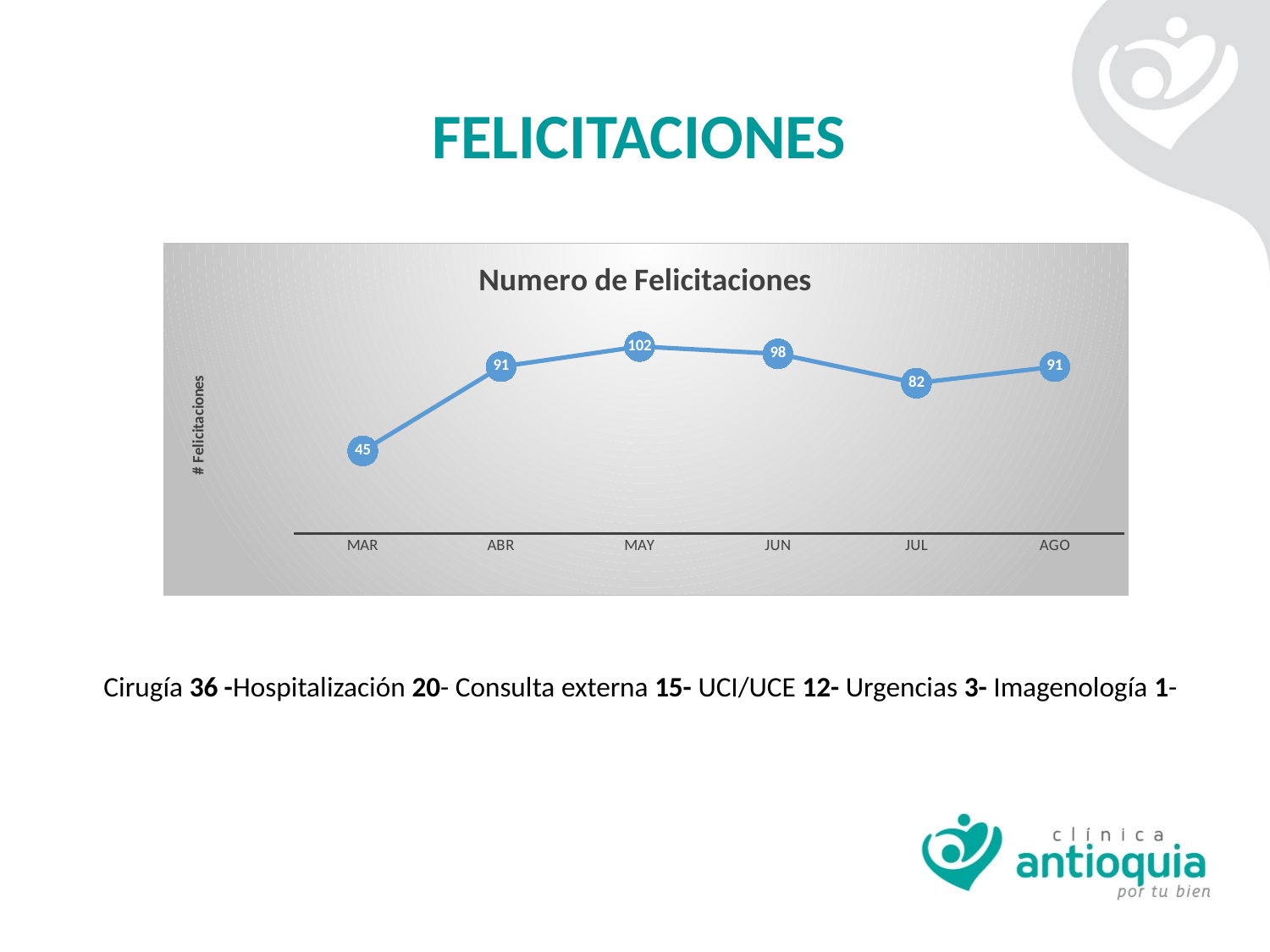
What is the value for MAY in the chart? 102 What is the value for MAR in the chart? 45 Which month has the highest number of felicitaciones? MAY What is the difference between the values for MAY and MAR? 57 What kind of chart is shown on the slide? line chart What is the difference between the values for JUN and JUL? 16 Which month has the lowest number of felicitaciones? MAR What is the title of the chart? Numero de Felicitaciones How many months are plotted in the chart? 6 Which is larger, the value for JUN or the value for AGO? JUN Do the values rise or fall from MAR to MAY? rise What is the value for JUL in the chart? 82